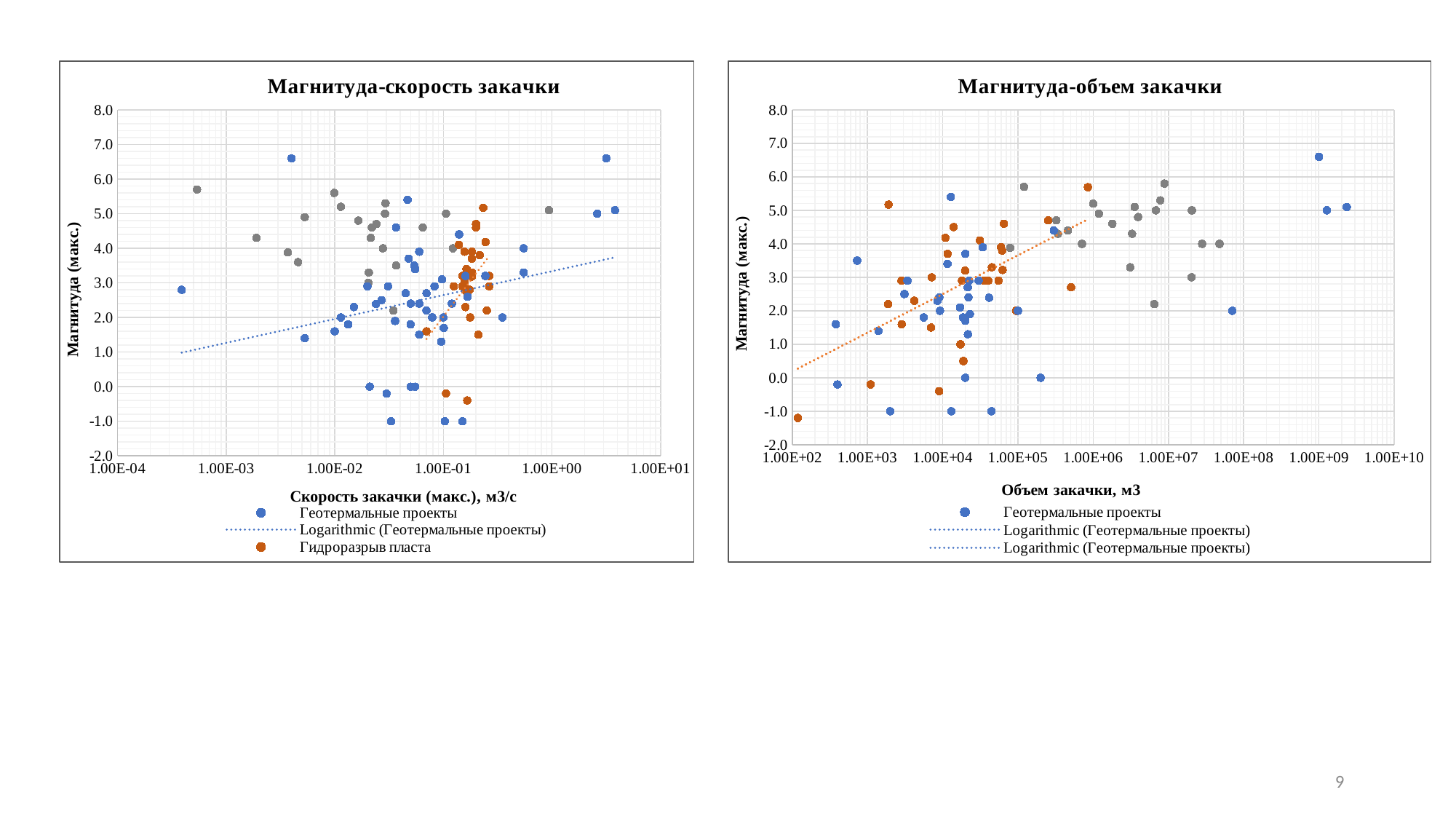
What is the x-axis label of the right chart "Магнитуда-объем закачки"? Объем закачки, м3 In the left chart "Магнитуда-скорость закачки", does the dotted logarithmic trendline for Геотермальные проекты rise or fall as injection rate increases along the x axis? rise What kind of chart is the left chart titled "Магнитуда-скорость закачки"? scatter chart What kind of chart is the right chart titled "Магнитуда-объем закачки"? scatter chart How many entries does the legend of the right chart "Магнитуда-объем закачки" list? 3 In the left chart "Магнитуда-скорость закачки", is the highest Геотермальные проекты point greater or less than 6.0? greater In the right chart "Магнитуда-объем закачки", does the dotted trendline rise or fall as injection volume increases along the x axis? rise How many entries does the legend of the left chart "Магнитуда-скорость закачки" list? 3 What is the x-axis label of the left chart "Магнитуда-скорость закачки"? Скорость закачки (макс.), м3/с In the right chart "Магнитуда-объем закачки", is the lowest plotted point greater or less than -1.0? less